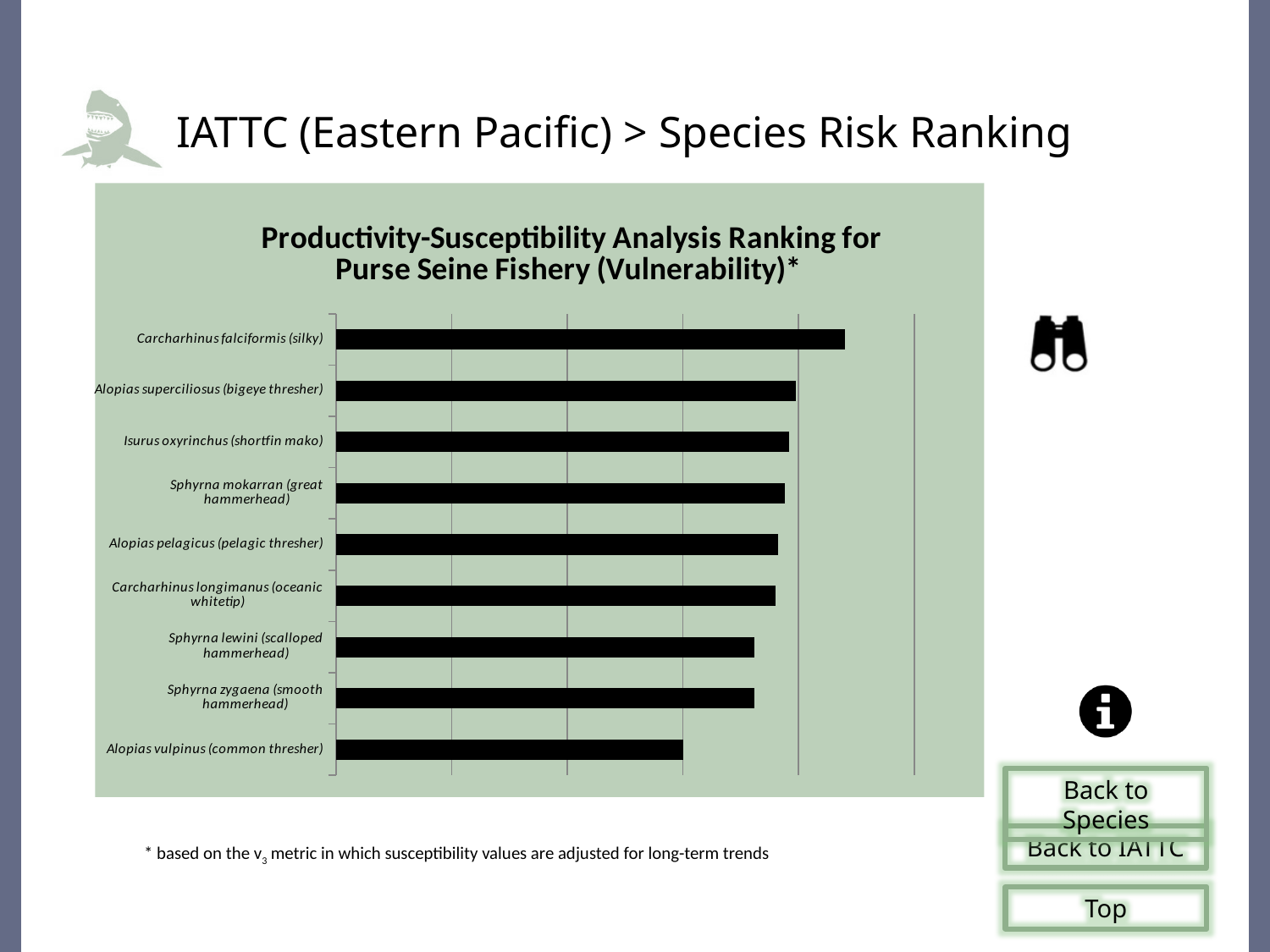
Which species has the longest bar in the chart? Carcharhinus falciformis (silky) Which has the larger value, Isurus oxyrinchus (shortfin mako) or Sphyrna zygaena (smooth hammerhead)? Isurus oxyrinchus (shortfin mako) Which has the larger value, Alopias superciliosus (bigeye thresher) or Sphyrna lewini (scalloped hammerhead)? Alopias superciliosus (bigeye thresher) Which species has the shortest bar in the chart? Alopias vulpinus (common thresher) Which has the larger value, Alopias pelagicus (pelagic thresher) or Alopias vulpinus (common thresher)? Alopias pelagicus (pelagic thresher) What colour are the bars in the chart? black How many species are listed in the chart? 9 What kind of chart is shown on the slide? bar chart Do the bar lengths increase or decrease going from the top of the chart to the bottom? decrease What is the title of the chart? Productivity-Susceptibility Analysis Ranking for Purse Seine Fishery (Vulnerability)* Which species is listed second from the top in the chart? Alopias superciliosus (bigeye thresher)